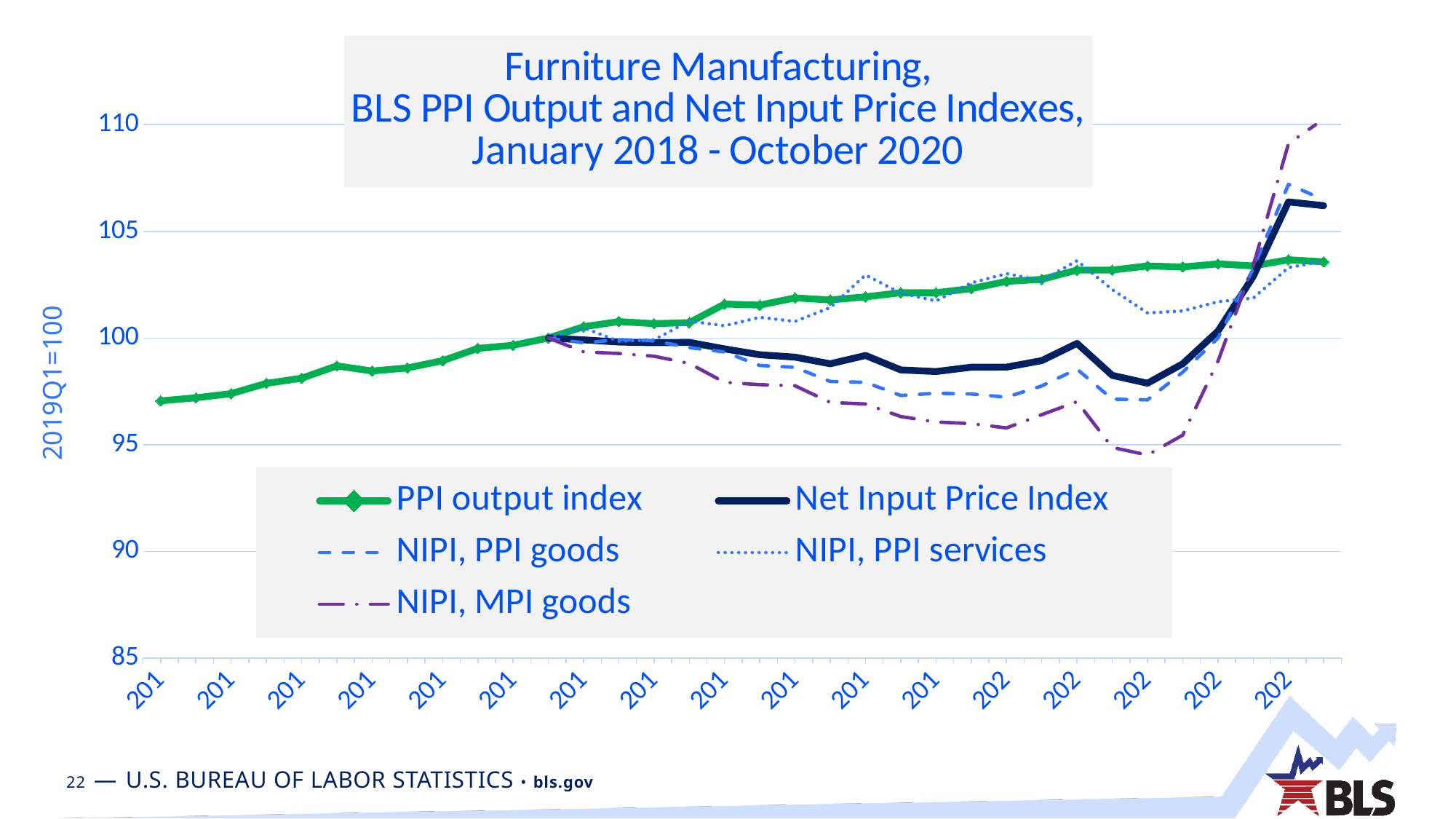
Is the lowest point of the NIPI, MPI goods series greater or less than 95? less What is the title of the chart? Furniture Manufacturing, BLS PPI Output and Net Input Price Indexes, January 2018 - October 2020 Does the PPI output index rise or fall over the period shown? Rise Is the first value of the PPI output index greater or less than 100? less What is the label on the vertical axis? 2019Q1=100 Is the final value of the Net Input Price Index greater or less than 105? greater Which series reaches the highest value on the chart? NIPI, MPI goods Which series falls to the lowest value on the chart? NIPI, MPI goods How many series does the legend list? 5 At the right end of the chart, which is higher: the Net Input Price Index or the PPI output index? Net Input Price Index What kind of chart is shown on the slide? Line chart